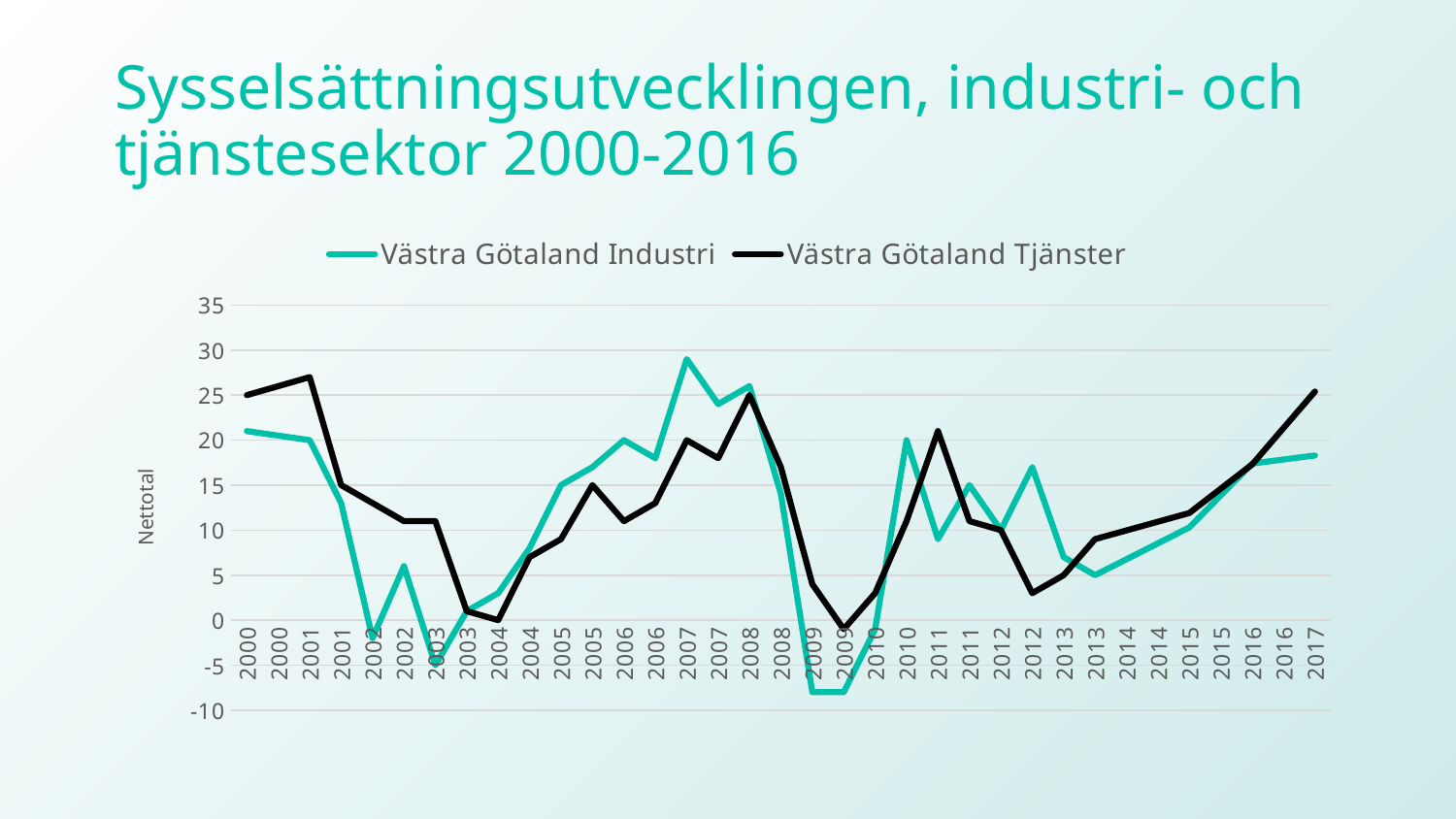
Which series is drawn in black according to the legend? Västra Götaland Tjänster Does the Västra Götaland Tjänster line rise or fall from 2013 to 2017? Rise At 2017, which series has the higher value, Västra Götaland Industri or Västra Götaland Tjänster? Västra Götaland Tjänster In which year does Västra Götaland Industri reach its highest value? 2007 Is the lowest value for Västra Götaland Industri in 2009 greater or less than -5? less How many series does the legend list? 2 Is the value for Västra Götaland Industri at 2017 greater or less than 20? less What is the label on the vertical axis? Nettotal What kind of chart is shown on the slide? Line chart Is the value for Västra Götaland Industri at the first 2007 point greater or less than 25? greater At the first 2007 point, which series has the higher value, Västra Götaland Industri or Västra Götaland Tjänster? Västra Götaland Industri